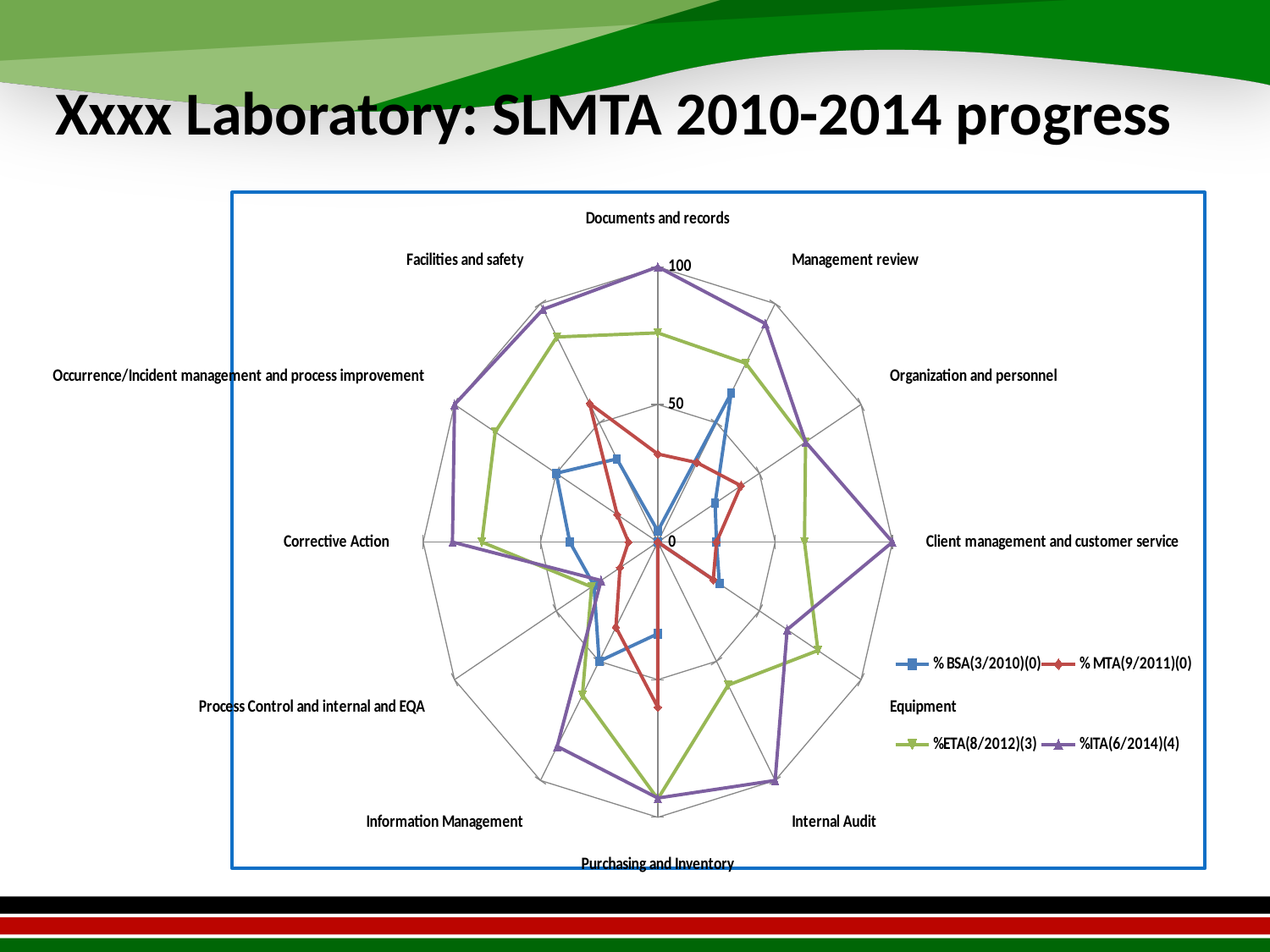
What kind of chart is shown on the slide? Radar chart What is the title of the slide containing the chart? Xxxx Laboratory: SLMTA 2010-2014 progress Is the %ITA(6/2014)(4) value for Internal Audit greater or less than 50? greater Is the %ETA(8/2012)(3) value for Documents and records greater or less than 50? greater Is the %ITA(6/2014)(4) value for Documents and records greater or less than 50? greater How many categories (axes) does the radar chart have? 12 How many series does the legend list? 4 For Documents and records, which series has the larger value: %ITA(6/2014)(4) or % BSA(3/2010)(0)? %ITA(6/2014)(4) Which series is drawn in purple with triangle markers? %ITA(6/2014)(4)